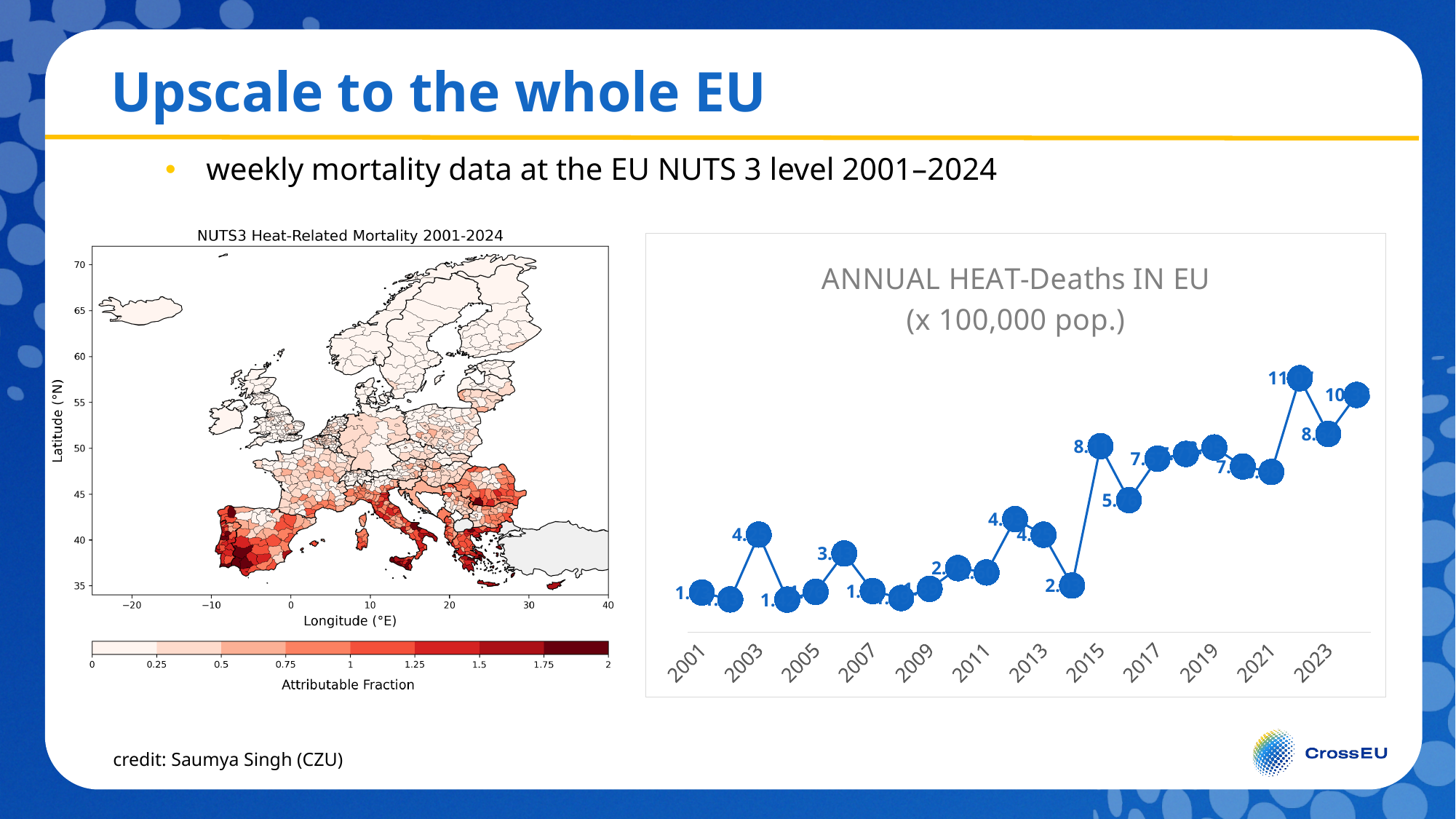
What is the first year shown on the x axis of the 'ANNUAL HEAT-Deaths IN EU' chart? 2001 In the 'ANNUAL HEAT-Deaths IN EU' chart, which year has the larger value, 2003 or 2001? 2003 In the 'ANNUAL HEAT-Deaths IN EU' chart, which year has the larger value, 2015 or 2014? 2015 In the 'ANNUAL HEAT-Deaths IN EU' chart, which year has the highest value? 2022 In the 'ANNUAL HEAT-Deaths IN EU' chart, which year has the larger value, 2016 or 2015? 2015 What kind of chart is the 'ANNUAL HEAT-Deaths IN EU' chart on the right of the slide? line chart In the 'ANNUAL HEAT-Deaths IN EU' chart, what is the overall trend of annual heat deaths from 2001 to 2024? rising In the 'ANNUAL HEAT-Deaths IN EU' chart, how many data series are plotted? 1 In the 'ANNUAL HEAT-Deaths IN EU' chart, how many yearly data points are plotted? 24 What is the title of the map chart on the left of the slide? NUTS3 Heat-Related Mortality 2001-2024